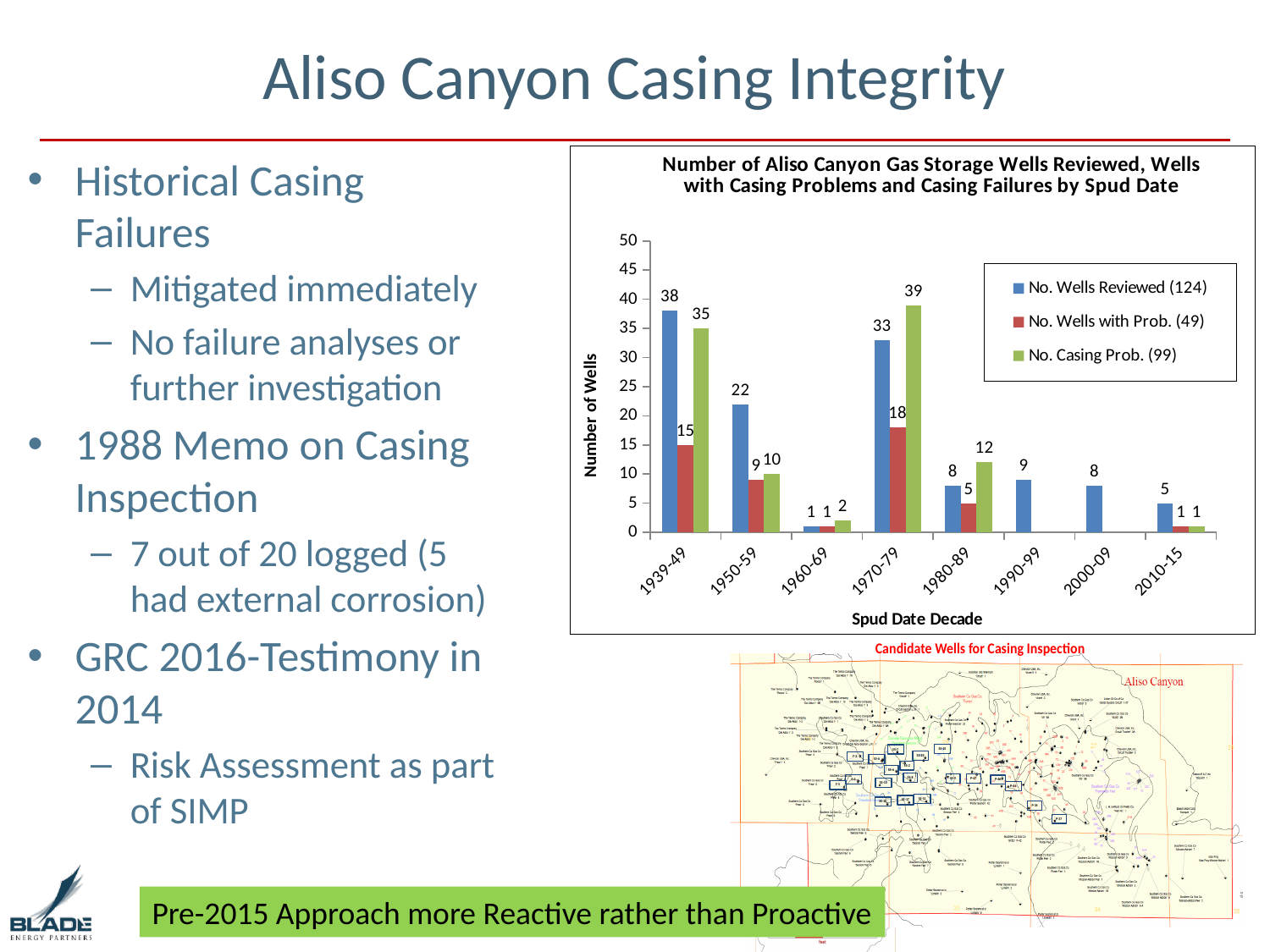
Which decade has the highest number of casing problems? 1970-79 What type of chart is shown on the slide? bar chart What is the number of wells reviewed for the 1939-49 decade? 38 Which decade has the highest number of wells reviewed? 1939-49 Which is larger for the 1980-89 decade: the number of wells reviewed or the number of casing problems? No. Casing Prob. What is the title of the x axis? Spud Date Decade How many spud date decade categories are shown on the x axis? 8 What is the number of casing problems for the 1970-79 decade? 39 What is the number of wells with problems for the 1950-59 decade? 9 What is the difference between the number of wells reviewed and the number of wells with problems in the 1970-79 decade? 15 What total is shown in the legend for No. Wells Reviewed? 124 How many series does the chart legend list? 3